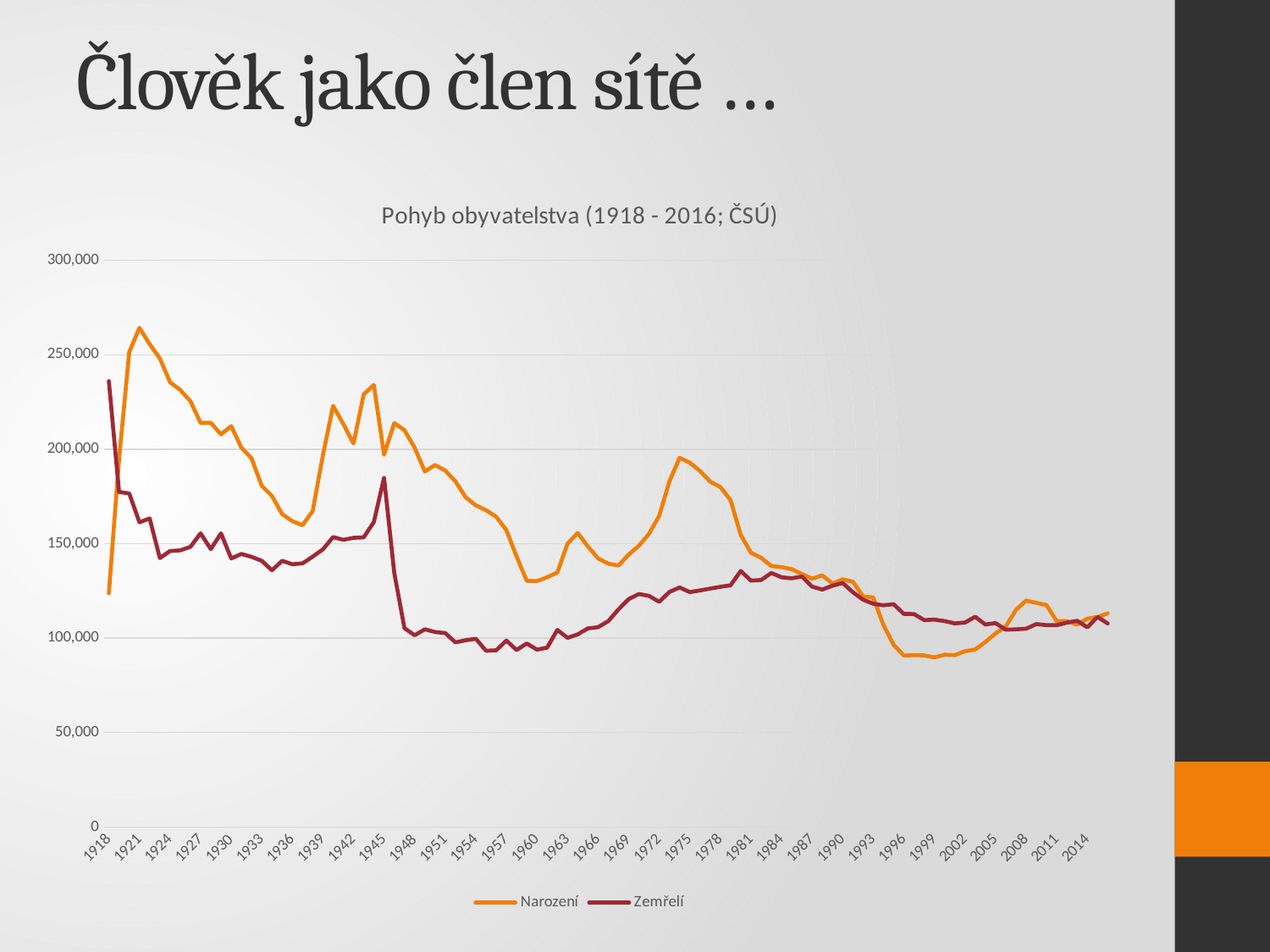
What is the title of the chart? Pohyb obyvatelstva (1918 - 2016; ČSÚ) Is the value for Zemřelí in 1918 greater or less than 200,000? greater In 1921, which series has the larger value, Narození or Zemřelí? Narození How many series does the legend list? 2 What kind of chart is shown on the slide? line chart In 1918, which series has the larger value, Narození or Zemřelí? Zemřelí Is the value for Narození in 1996 greater or less than 100,000? less In 1996, which series has the larger value, Narození or Zemřelí? Zemřelí Which colour is used for the Narození series? orange Is the value for Narození in 1921 greater or less than 250,000? greater Does the Narození series rise or fall between 1975 and 1996? fall